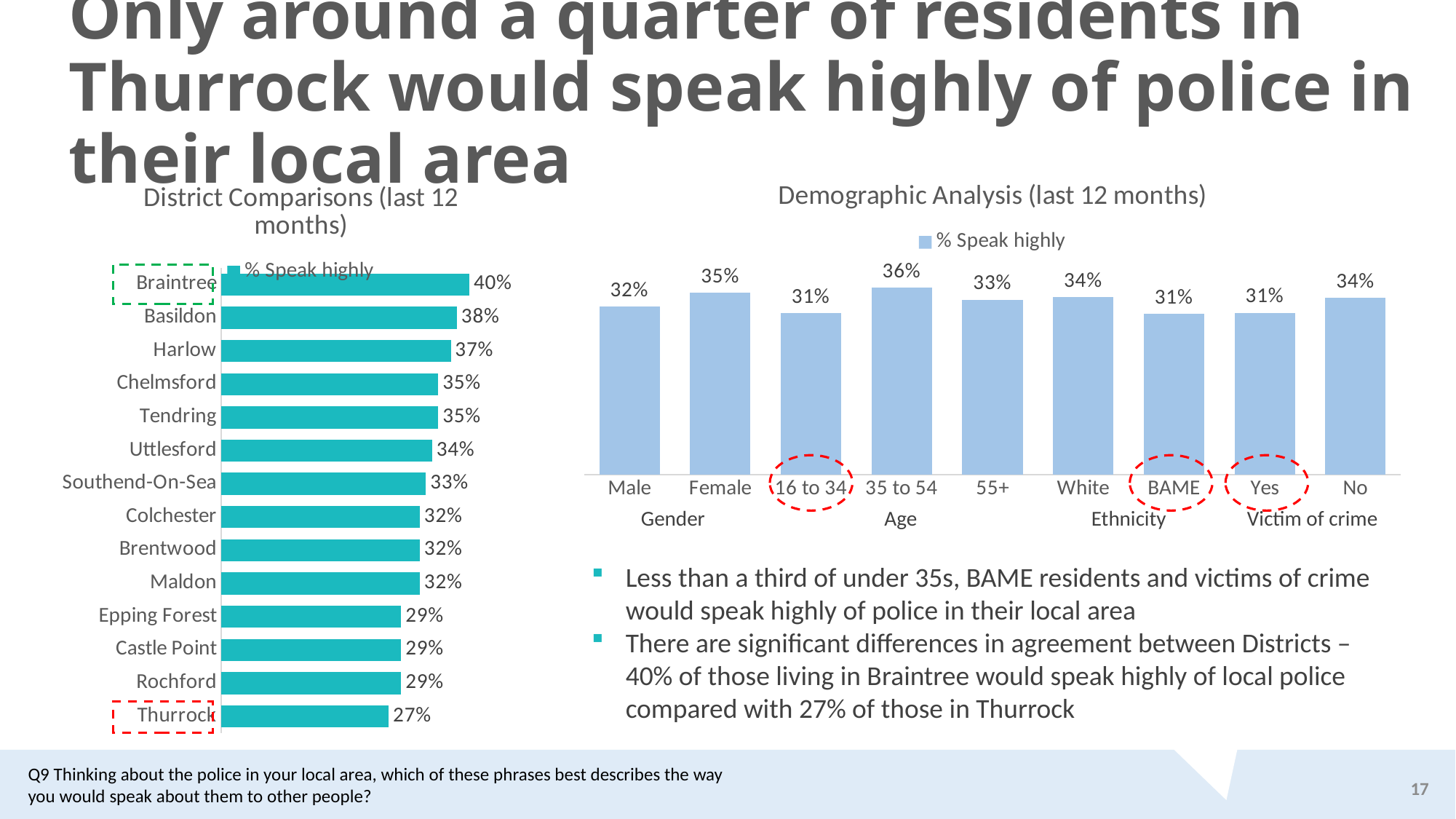
In the Demographic Analysis chart, what is the % Speak highly value for 35 to 54? 36% In the Demographic Analysis chart, which category has the highest value? 35 to 54 In the Demographic Analysis chart, which is larger, the value for Male or the value for Female? Female In the District Comparisons chart, what is the difference between the values for Braintree and Thurrock? 13% In the District Comparisons chart, what is the value for Uttlesford? 34% In the District Comparisons chart, which district has the lowest % Speak highly value? Thurrock In the District Comparisons chart, which district has the highest % Speak highly value? Braintree What kind of chart is the District Comparisons chart? Bar chart In the District Comparisons chart, how many districts are shown? 14 In the District Comparisons chart, what is the % Speak highly value for Harlow? 37% In the Demographic Analysis chart, how many categories are plotted? 9 In the Demographic Analysis chart, what is the difference between the values for White and BAME? 3%